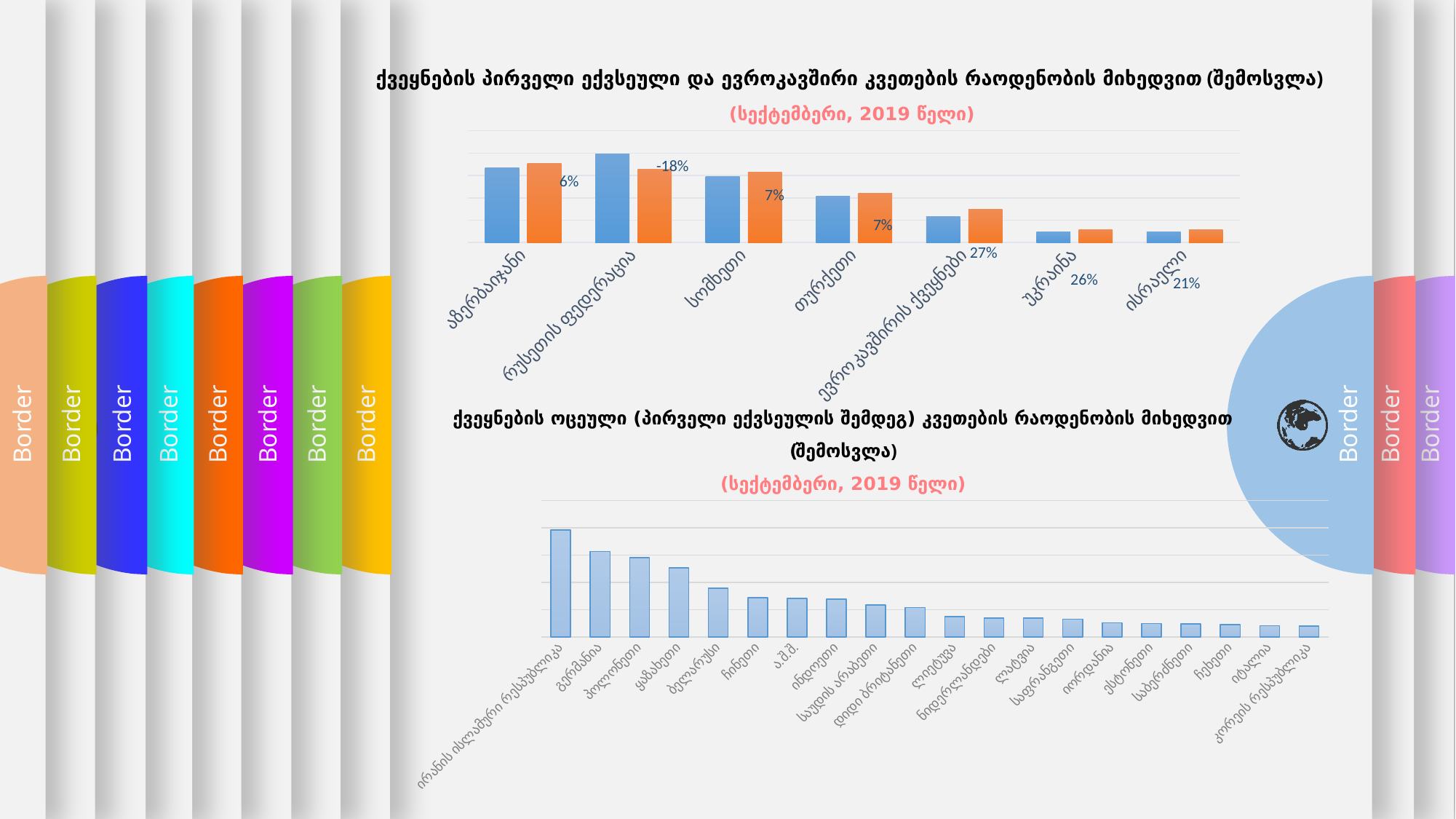
In the top chart, which category has the tallest bar? რუსეთის ფედერაცია In the top chart, how many categories are shown on the x axis? 7 In the top chart, what percentage label is shown for უკრაინა? 26% In the top chart, what percentage label is shown for რუსეთის ფედერაცია? -18% In the top chart, what percentage label is shown for ევროკავშირის ქვეყნები? 27% What type of chart is the top chart on the slide? bar chart In the top chart, which has the taller blue bar: აზერბაიჯანი or სომხეთი? აზერბაიჯანი In the top chart, what percentage label is shown for ისრაელი? 21% In the bottom chart, do the bar values rise or fall from left to right? fall In the bottom chart, which country has the highest bar? ირანის ისლამური რესპუბლიკა In the top chart, how many bar series are plotted for each category? 2 In the bottom chart, how many countries are shown? 20